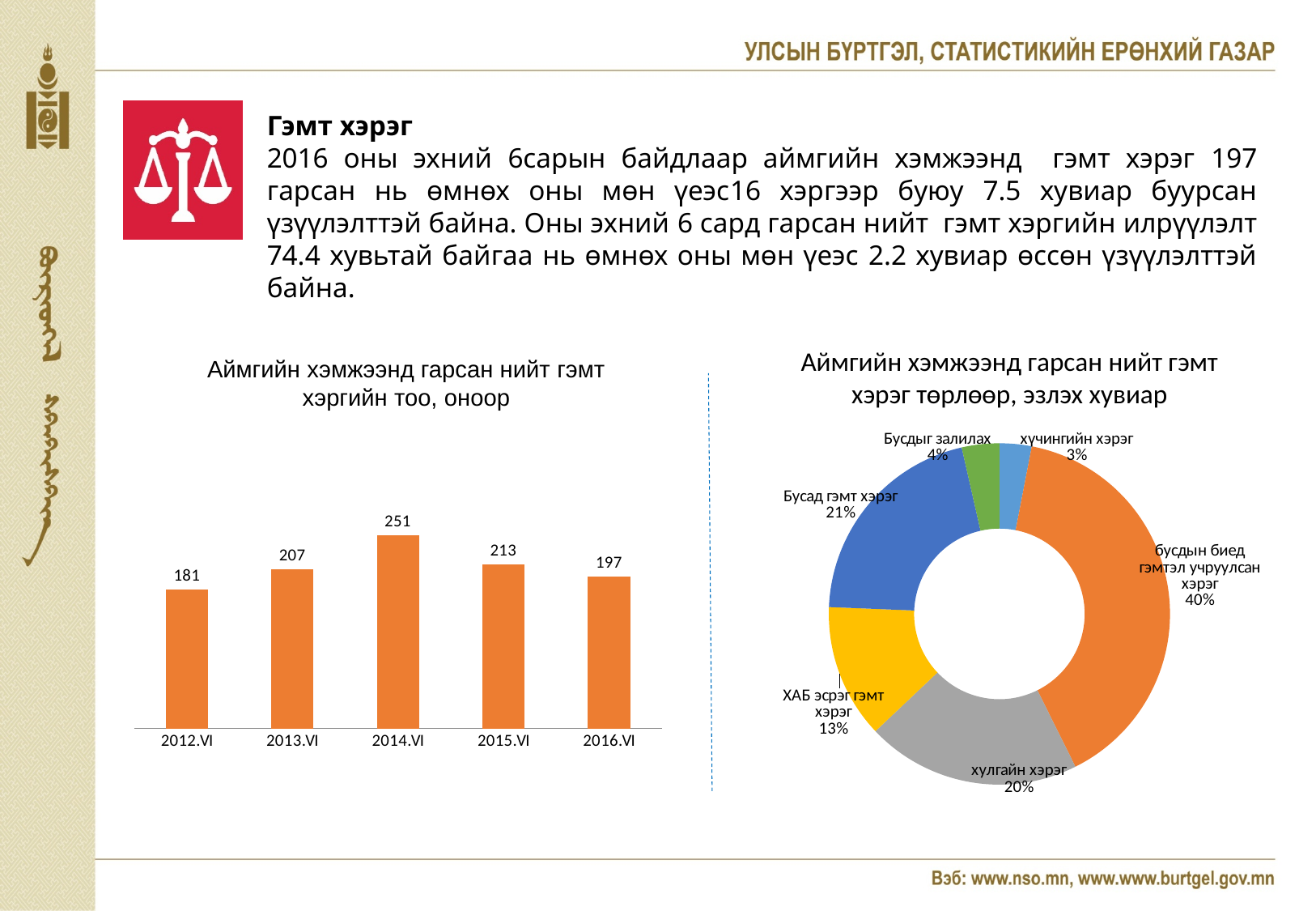
In the right chart (Аймгийн хэмжээнд гарсан нийт гэмт хэрэг төрлөөр, эзлэх хувиар), what share does бусдын биед гэмтэл учруулсан хэрэг have? 40% In the left chart (Аймгийн хэмжээнд гарсан нийт гэмт хэргийн тоо, оноор), which year has the highest value? 2014.VI In the left chart (Аймгийн хэмжээнд гарсан нийт гэмт хэргийн тоо, оноор), do the values rise or fall from 2014.VI to 2016.VI? Fall How many bars are shown in the left chart (Аймгийн хэмжээнд гарсан нийт гэмт хэргийн тоо, оноор)? 5 In the left chart (Аймгийн хэмжээнд гарсан нийт гэмт хэргийн тоо, оноор), which is larger, the value for 2013.VI or 2015.VI? 2015.VI In the right chart (Аймгийн хэмжээнд гарсан нийт гэмт хэрэг төрлөөр, эзлэх хувиар), which category has the smallest share? хүчингийн хэрэг How many categories are shown in the right chart (Аймгийн хэмжээнд гарсан нийт гэмт хэрэг төрлөөр, эзлэх хувиар)? 6 In the left chart (Аймгийн хэмжээнд гарсан нийт гэмт хэргийн тоо, оноор), what is the value for 2014.VI? 251 In the left chart (Аймгийн хэмжээнд гарсан нийт гэмт хэргийн тоо, оноор), what is the value for 2016.VI? 197 What kind of chart is the left chart (Аймгийн хэмжээнд гарсан нийт гэмт хэргийн тоо, оноор)? Bar chart In the left chart (Аймгийн хэмжээнд гарсан нийт гэмт хэргийн тоо, оноор), which year has the lowest value? 2012.VI In the left chart (Аймгийн хэмжээнд гарсан нийт гэмт хэргийн тоо, оноор), what is the difference between the values for 2015.VI and 2016.VI? 16